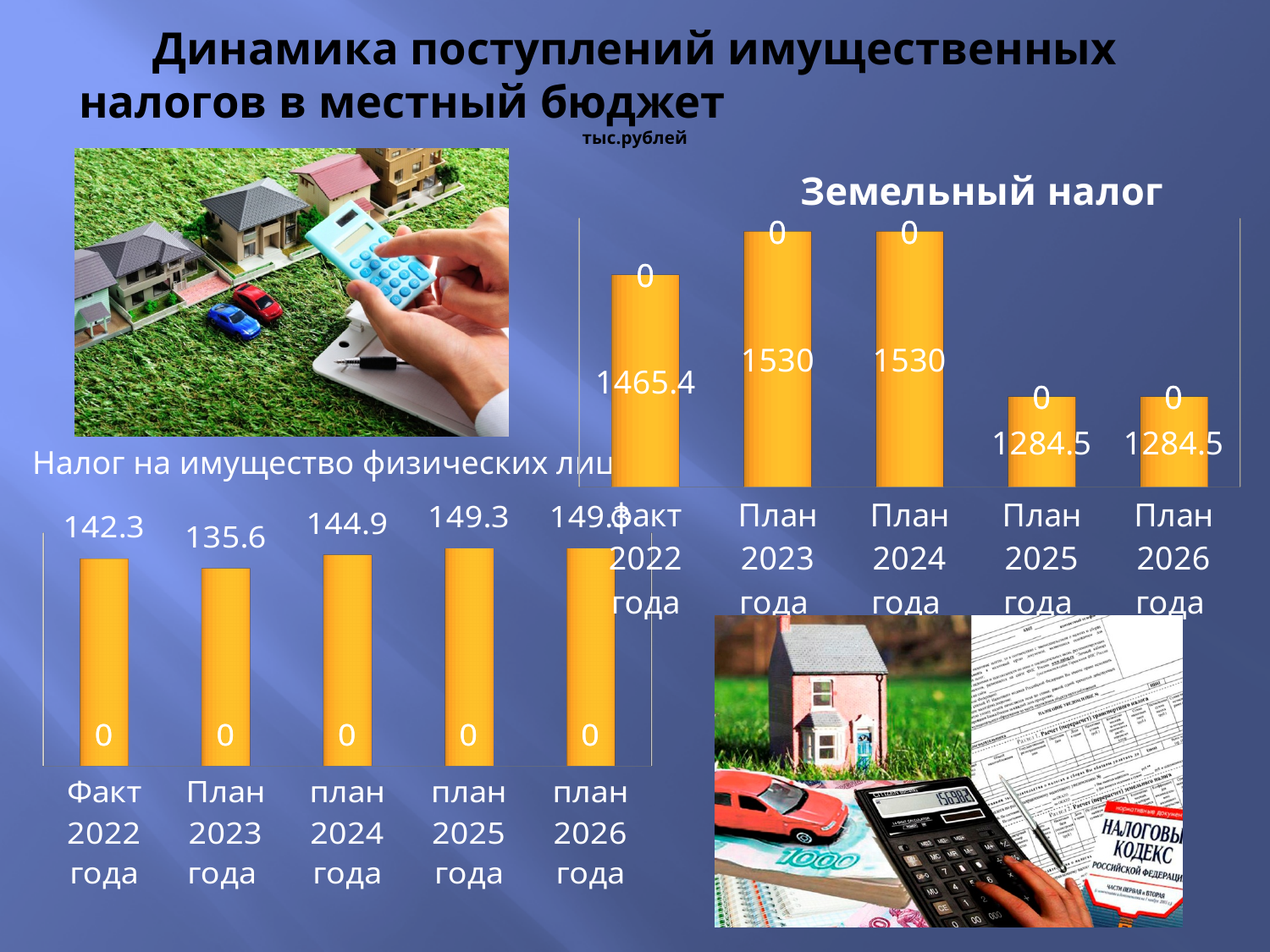
In the Земельный налог chart, what is the value for Факт 2022 года? 1465.4 In the Земельный налог chart, what is the difference between the values for План 2023 года and Факт 2022 года? 64.6 In the Земельный налог chart, which is larger: the value for Факт 2022 года or the value for План 2025 года? Факт 2022 года What unit of measurement is stated for the charts on the slide? тыс.рублей In the Налог на имущество физических лиц chart, what is the value for План 2023 года? 135.6 In the Налог на имущество физических лиц chart, what is the difference between the values for план 2024 года and Факт 2022 года? 2.6 In the Земельный налог chart, what is the difference between the values for План 2024 года and План 2026 года? 245.5 In the Налог на имущество физических лиц chart, which category has the lowest value? План 2023 года In the Налог на имущество физических лиц chart, what is the value for план 2025 года? 149.3 In the Земельный налог chart, what is the value for План 2023 года? 1530 How many categories are shown on the x axis of the Земельный налог chart? 5 In the Земельный налог chart, what is the value for План 2025 года? 1284.5